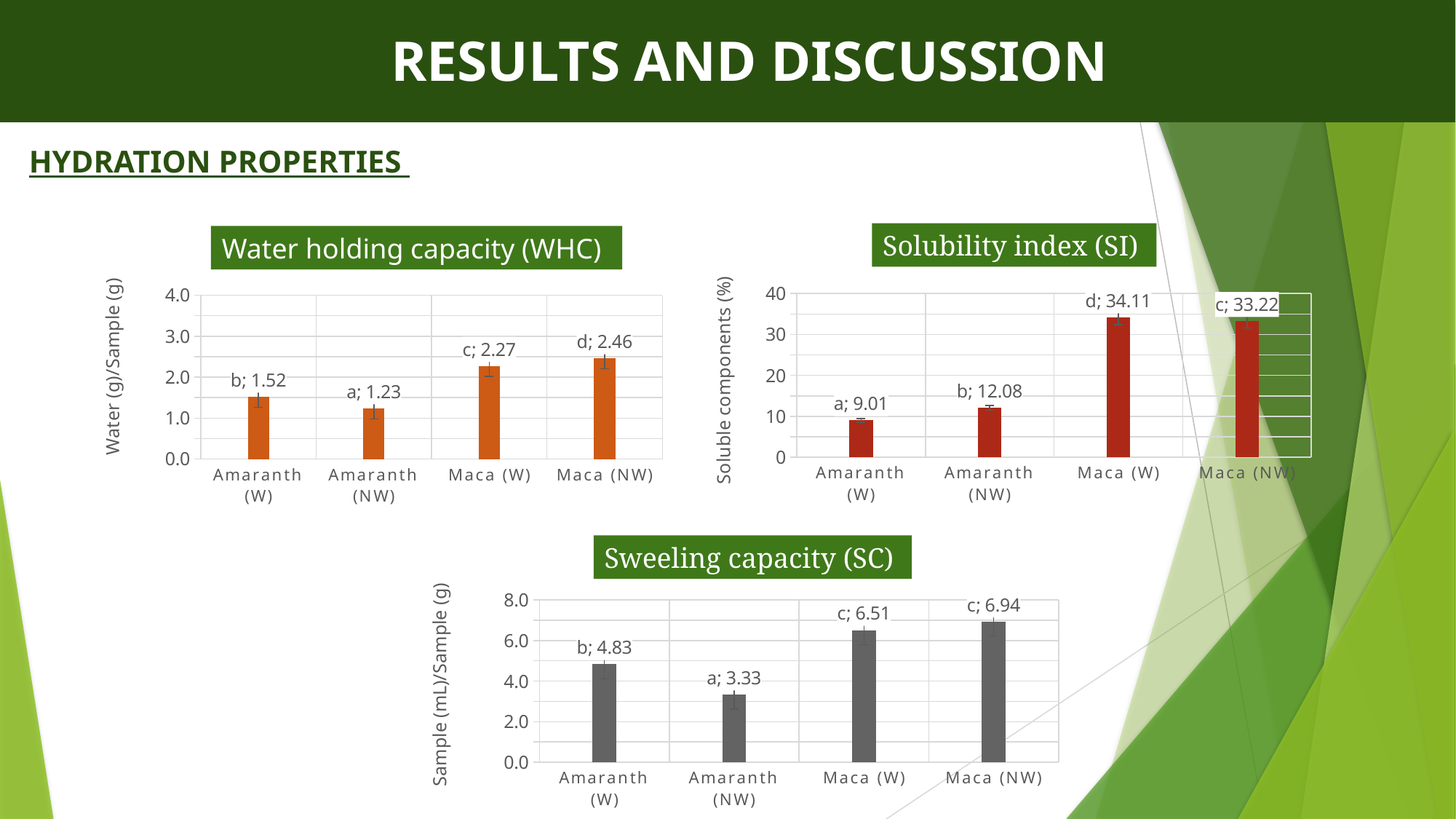
In the Solubility index (SI) chart, what is the difference between Maca (W) and Amaranth (W)? 25.10 What type of chart is the Sweeling capacity (SC) chart? Bar chart In the Solubility index (SI) chart, which category has the highest value? Maca (W) In the Sweeling capacity (SC) chart, what is the value for Amaranth (W)? 4.83 In the Sweeling capacity (SC) chart, how many categories are shown on the x axis? 4 In the Water holding capacity (WHC) chart, which category has the lowest value? Amaranth (NW) In the Solubility index (SI) chart, is the value for Maca (NW) greater or less than 30? greater In the Water holding capacity (WHC) chart, what is the value for Maca (NW)? 2.46 In the Water holding capacity (WHC) chart, what is the difference between Maca (NW) and Amaranth (NW)? 1.23 In the Solubility index (SI) chart, what is the value for Amaranth (NW)? 12.08 In the Sweeling capacity (SC) chart, which is larger, Maca (W) or Maca (NW)? Maca (NW) What is the y-axis label of the Solubility index (SI) chart? Soluble components (%)